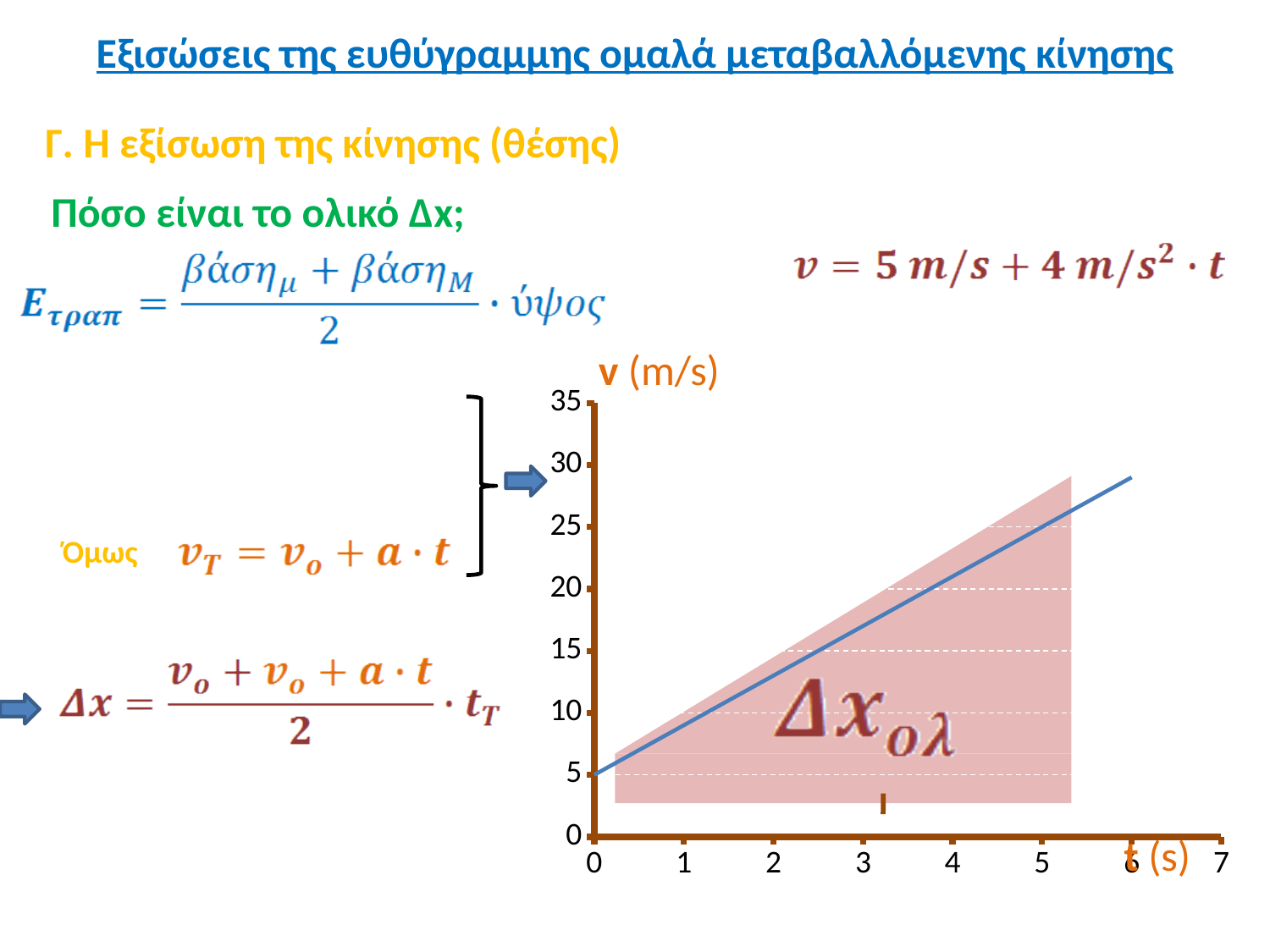
Does the velocity v rise or fall as t increases along the x axis? rise What is the highest tick value shown on the vertical axis? 35 Is the value of v at t = 6 greater or less than 25? greater Is the value of v at t = 4 greater or less than 20? greater What is the value of v at t = 0 on the chart? 5 Is the value of v at t = 6 greater or less than 30? less What kind of chart is shown on the slide? line chart What is the label of the vertical axis of the chart? v (m/s) Which is larger, the value of v at t = 1 or at t = 5? t = 5